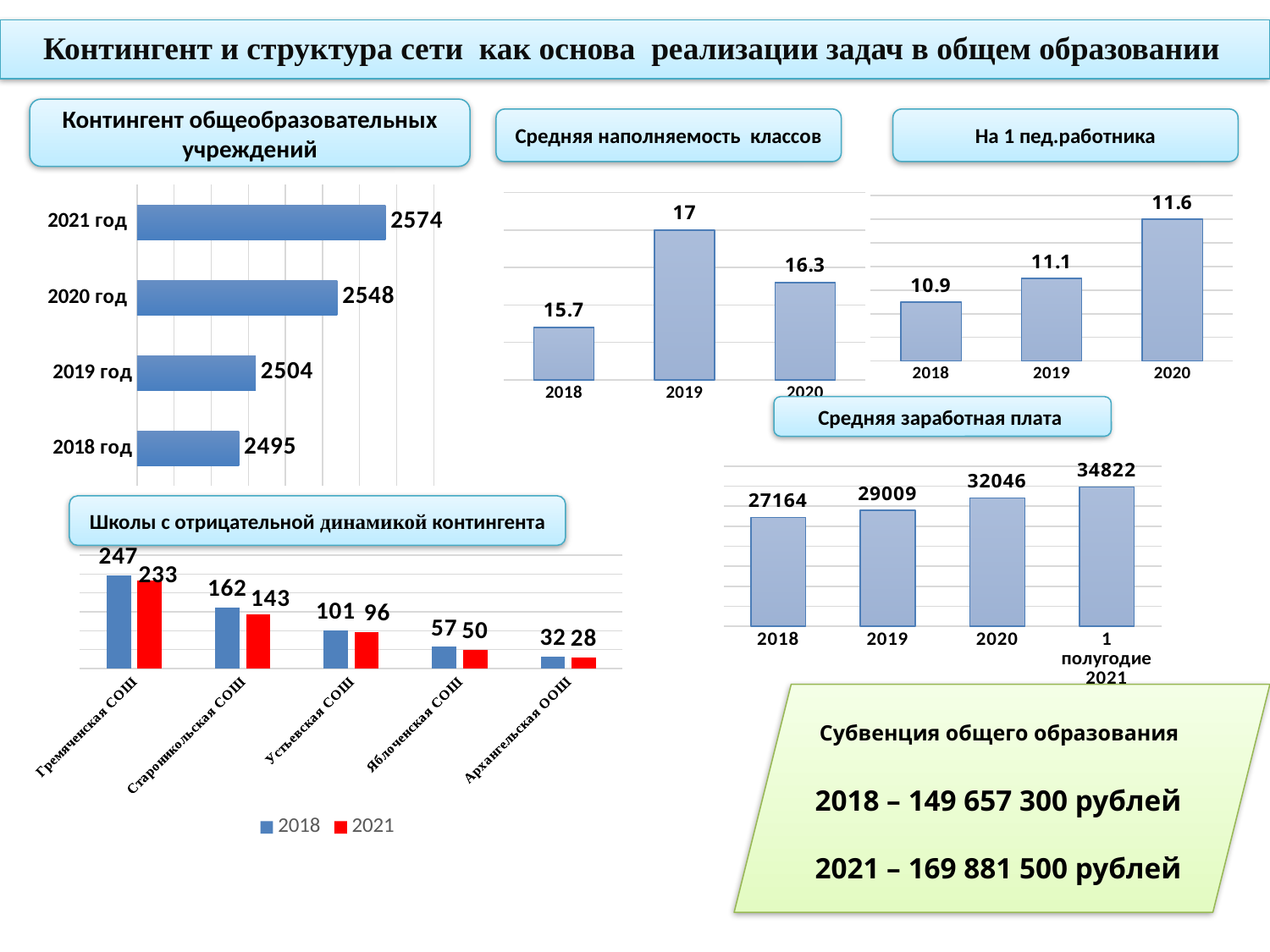
In the chart 'Контингент общеобразовательных учреждений', which year has the lowest value? 2018 год In the chart 'Средняя заработная плата', how many bars are plotted? 4 In the chart 'На 1 пед.работника', what is the value for 2019? 11.1 In the chart 'Школы с отрицательной динамикой контингента', which is larger: the 2018 value for Устьевская СОШ or the 2018 value for Яблоченская СОШ? Устьевская СОШ In the chart 'Школы с отрицательной динамикой контингента', how many series does the legend list? 2 In the chart 'Школы с отрицательной динамикой контингента', what is the 2021 value for Староникольская СОШ? 143 In the chart 'Контингент общеобразовательных учреждений', what is the value for 2021 год? 2574 In the chart 'Контингент общеобразовательных учреждений', what is the difference between the values for 2021 год and 2018 год? 79 In the chart 'Средняя наполняемость классов', which year has the highest value? 2019 In the chart 'Средняя наполняемость классов', what is the value for 2020? 16.3 In the chart 'На 1 пед.работника', do the values rise or fall from 2018 to 2020? rise In the chart 'Средняя заработная плата', what is the value for 1 полугодие 2021? 34822